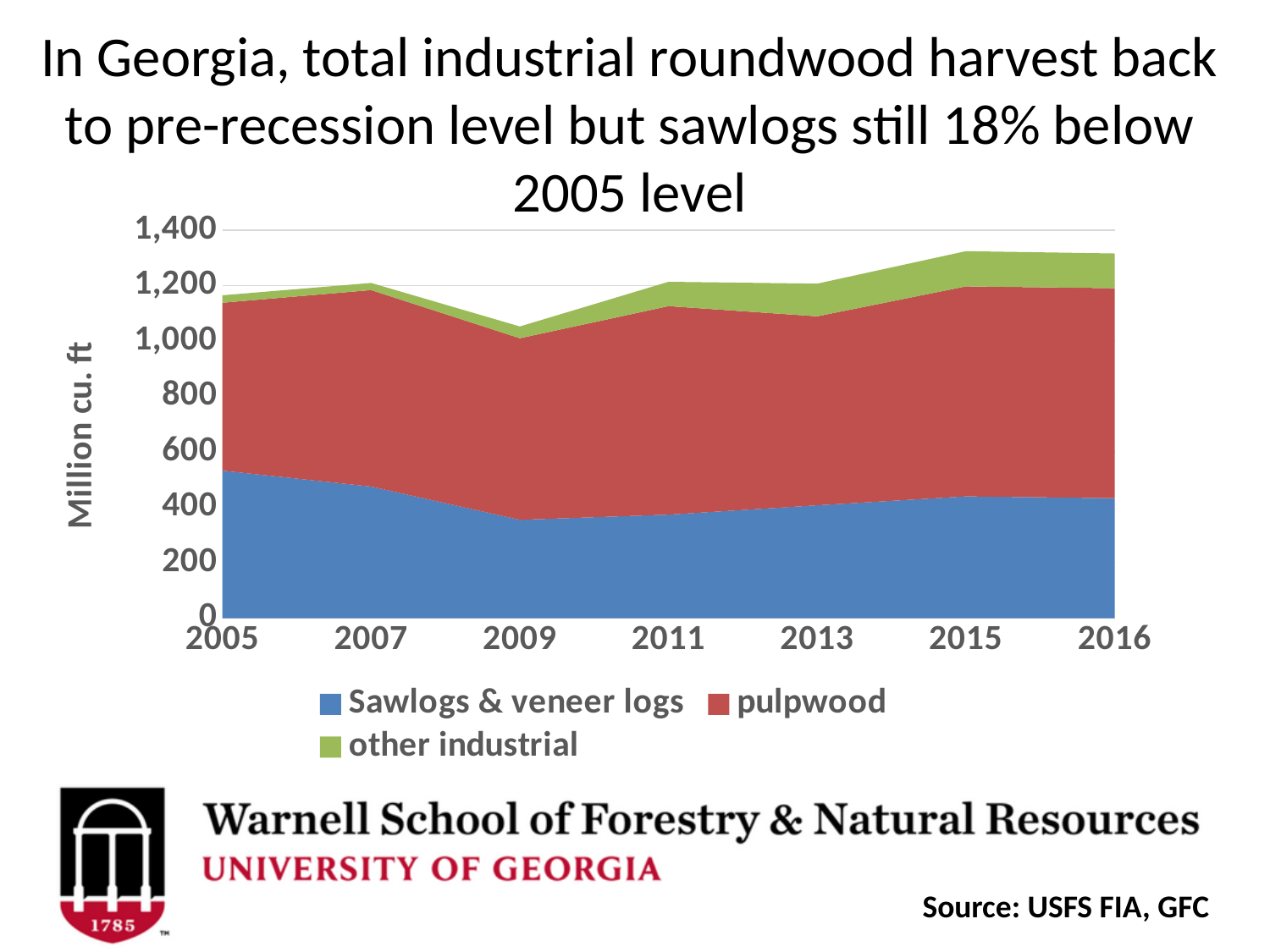
Is the Sawlogs & veneer logs value for 2009 greater or less than 400? less Which series is shown in green? other industrial Is the total harvest (top of the stack) for 2015 greater or less than 1,200? greater Which is larger, the Sawlogs & veneer logs value in 2005 or in 2009? 2005 How many series does the legend list? 3 Does the Sawlogs & veneer logs value rise or fall from 2009 to 2016? rise Is the Sawlogs & veneer logs value for 2005 greater or less than 400? greater In which year is the total industrial roundwood harvest (top of the stack) lowest? 2009 What unit is shown on the y axis? Million cu. ft How many years are shown along the x axis? 7 What kind of chart is shown on the slide? Stacked area chart In which year is the Sawlogs & veneer logs value lowest? 2009